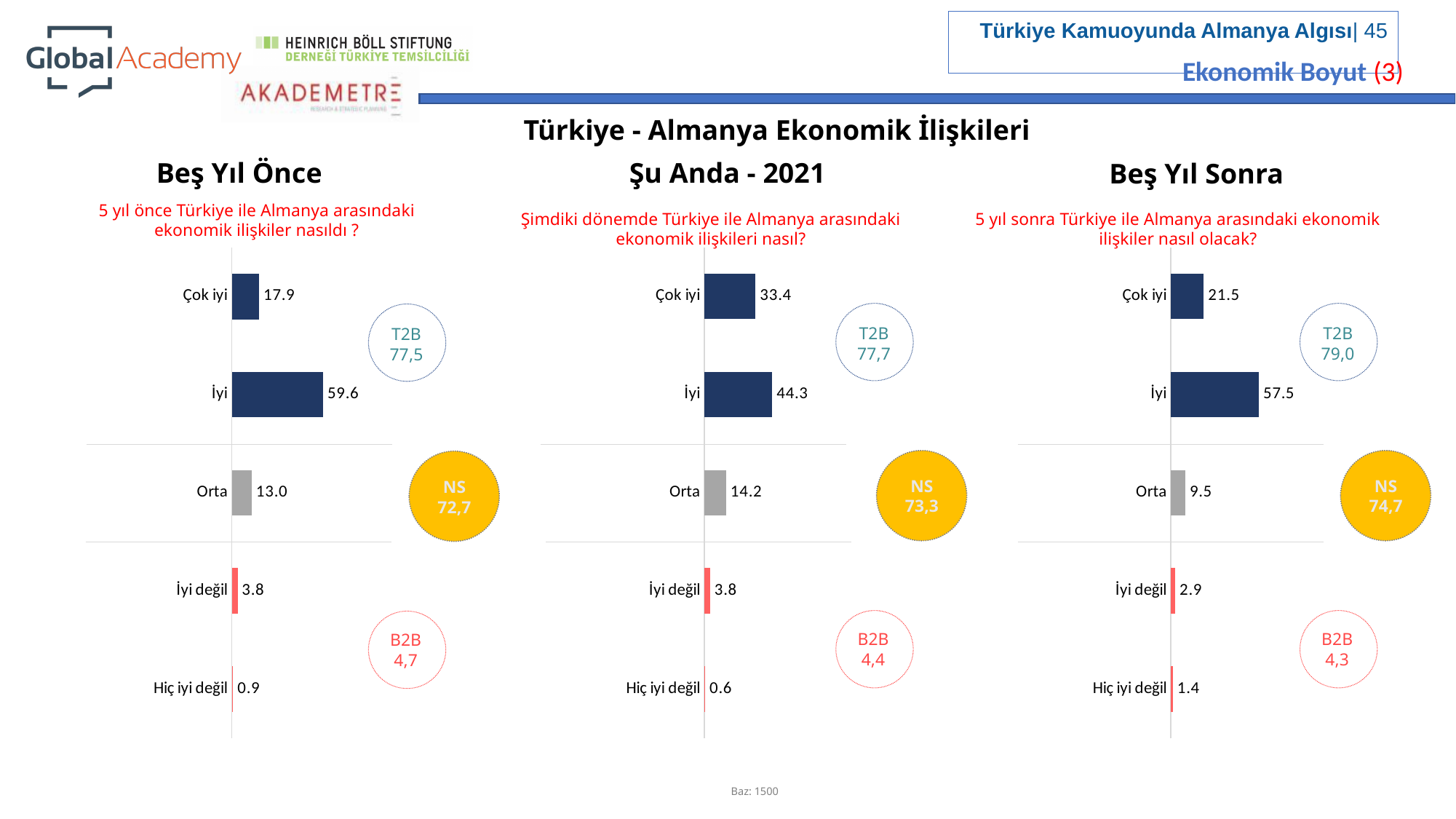
In the 'Şu Anda - 2021' chart, which category has the lowest value? Hiç iyi değil In the 'Beş Yıl Önce' chart, what is the value for 'İyi'? 59.6 How many categories are shown in the 'Beş Yıl Önce' chart? 5 In the 'Şu Anda - 2021' chart, what is the difference between the values for 'Orta' and 'İyi değil'? 10.4 In the 'Beş Yıl Sonra' chart, what is the value for 'Hiç iyi değil'? 1.4 In the 'Şu Anda - 2021' chart, what is the value for 'Çok iyi'? 33.4 What kind of chart is the 'Şu Anda - 2021' chart? Bar chart What is the overall title shown above the three charts? Türkiye - Almanya Ekonomik İlişkileri In the 'Beş Yıl Sonra' chart, which category has the highest value? İyi In the 'Beş Yıl Önce' chart, what is the difference between the values for 'İyi' and 'Çok iyi'? 41.7 Which is larger: the 'Çok iyi' value in the 'Şu Anda - 2021' chart or the 'Çok iyi' value in the 'Beş Yıl Sonra' chart? Şu Anda - 2021 In the 'Beş Yıl Sonra' chart, what is the value for 'Orta'? 9.5